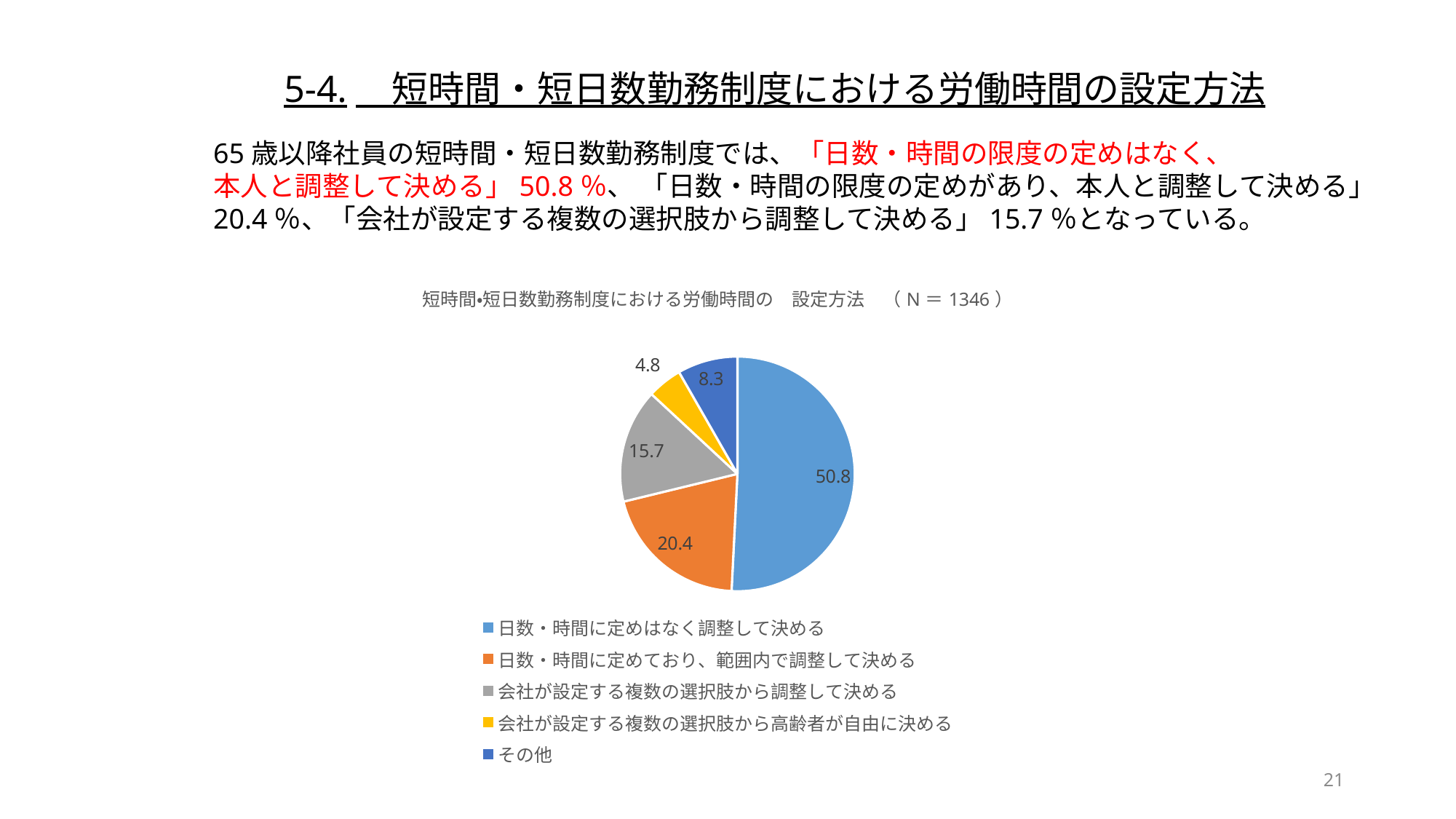
What is the N (sample size) shown in the chart title? 1346 How many categories does the legend list? 5 Which category has the largest slice of the pie? 日数・時間に定めはなく調整して決める Which is larger: the value for 「その他」 or the value for 「会社が設定する複数の選択肢から高齢者が自由に決める」? その他 Which category has the smallest slice of the pie? 会社が設定する複数の選択肢から高齢者が自由に決める What is the difference between the values for 「日数・時間に定めはなく調整して決める」 and 「日数・時間に定めており、範囲内で調整して決める」? 30.4 What is the value for 「日数・時間に定めはなく調整して決める」? 50.8 What kind of chart is shown on the slide? Pie chart What is the value for 「会社が設定する複数の選択肢から調整して決める」? 15.7 What is the value for 「日数・時間に定めており、範囲内で調整して決める」? 20.4 What is the value for 「その他」? 8.3 What is the value for 「会社が設定する複数の選択肢から高齢者が自由に決める」? 4.8